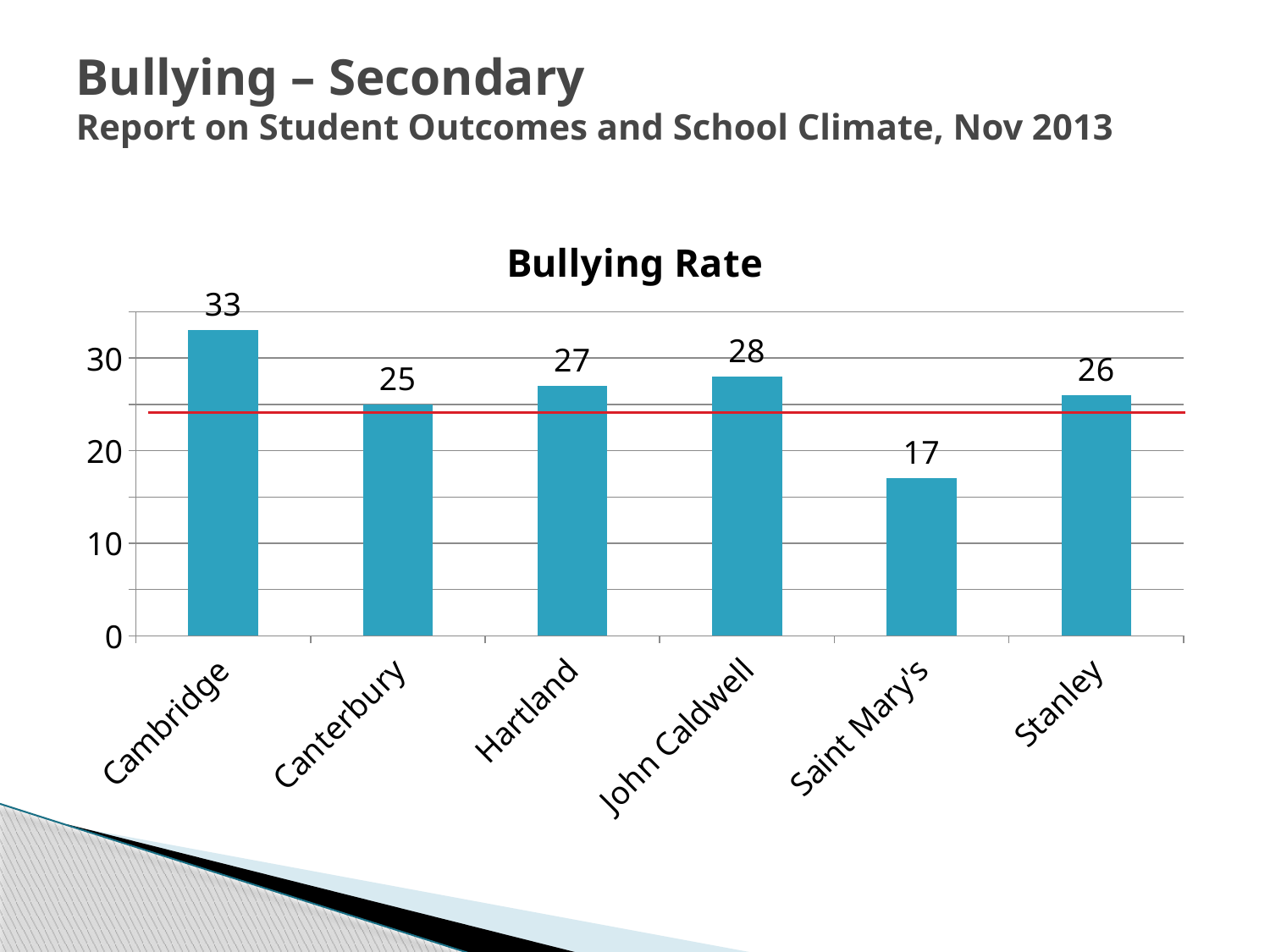
Which school has the highest bullying rate? Cambridge What is the title of the chart? Bullying Rate What is the bullying rate for Saint Mary's? 17 What is the bullying rate for Cambridge? 33 How many schools are shown in the chart? 6 What is the difference between the bullying rates of Cambridge and Saint Mary's? 16 What type of chart is shown on the slide? bar chart What is the bullying rate for John Caldwell? 28 Is the bullying rate for Saint Mary's greater or less than 20? less What is the difference between the bullying rates of Hartland and Canterbury? 2 Which school has the lowest bullying rate? Saint Mary's Which has a higher bullying rate, Stanley or Canterbury? Stanley